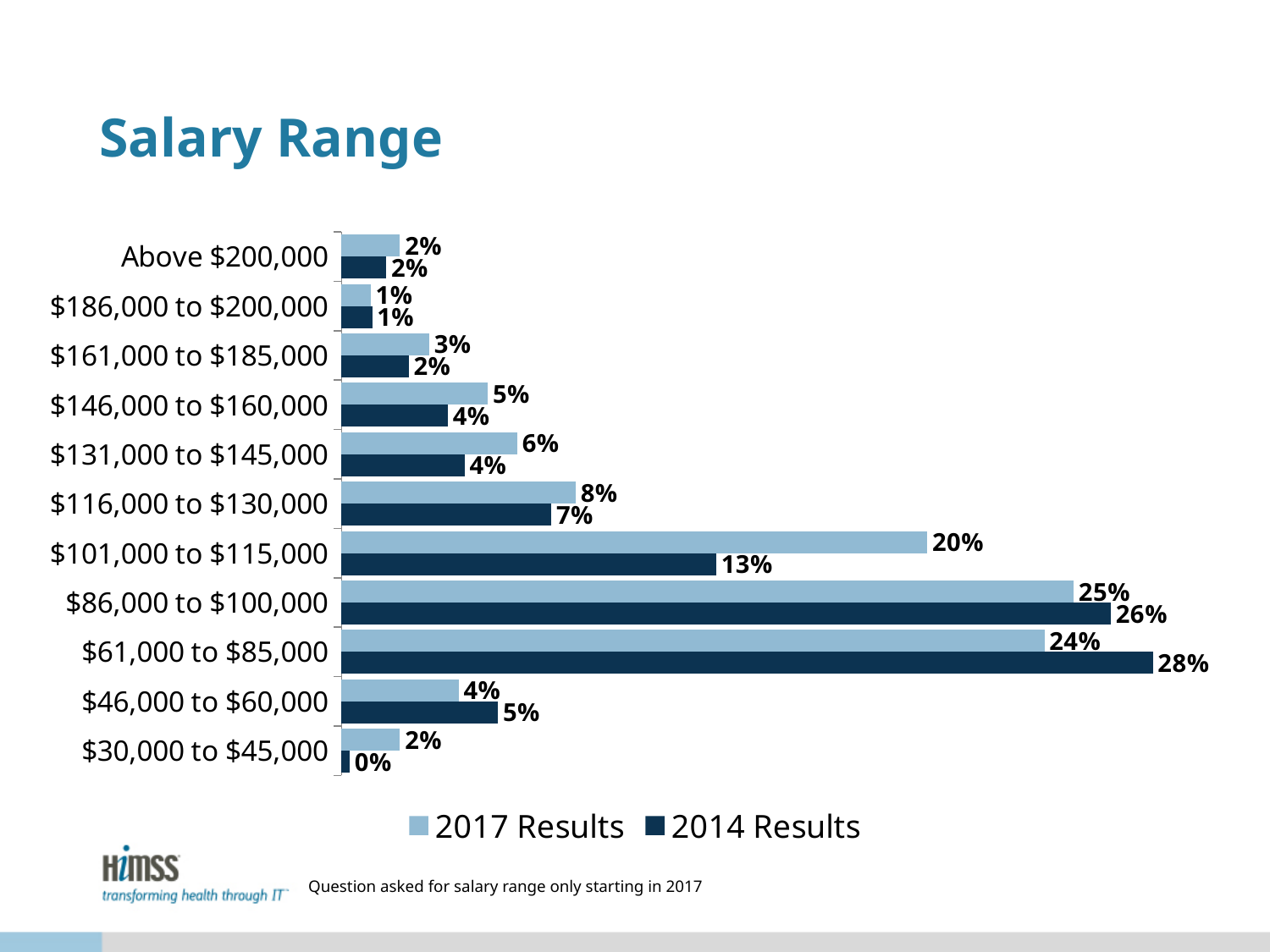
For the $46,000 to $60,000 range, which year had the larger share, 2017 or 2014? 2014 What type of chart is shown on the slide? Bar chart What is the difference between the 2017 and 2014 values for the $101,000 to $115,000 range? 7% What percentage of 2017 respondents reported a salary of $101,000 to $115,000? 20% What is the title of the slide? Salary Range Which salary range had the highest 2017 Results value? $86,000 to $100,000 How many series does the legend list? 2 What percentage of 2017 respondents fell in the $30,000 to $45,000 range? 2% How many salary range categories are shown on the chart? 11 What was the 2014 Results value for the $61,000 to $85,000 salary range? 28% Which salary range had the lowest 2014 Results value? $30,000 to $45,000 Which salary range had the highest 2014 Results value? $61,000 to $85,000